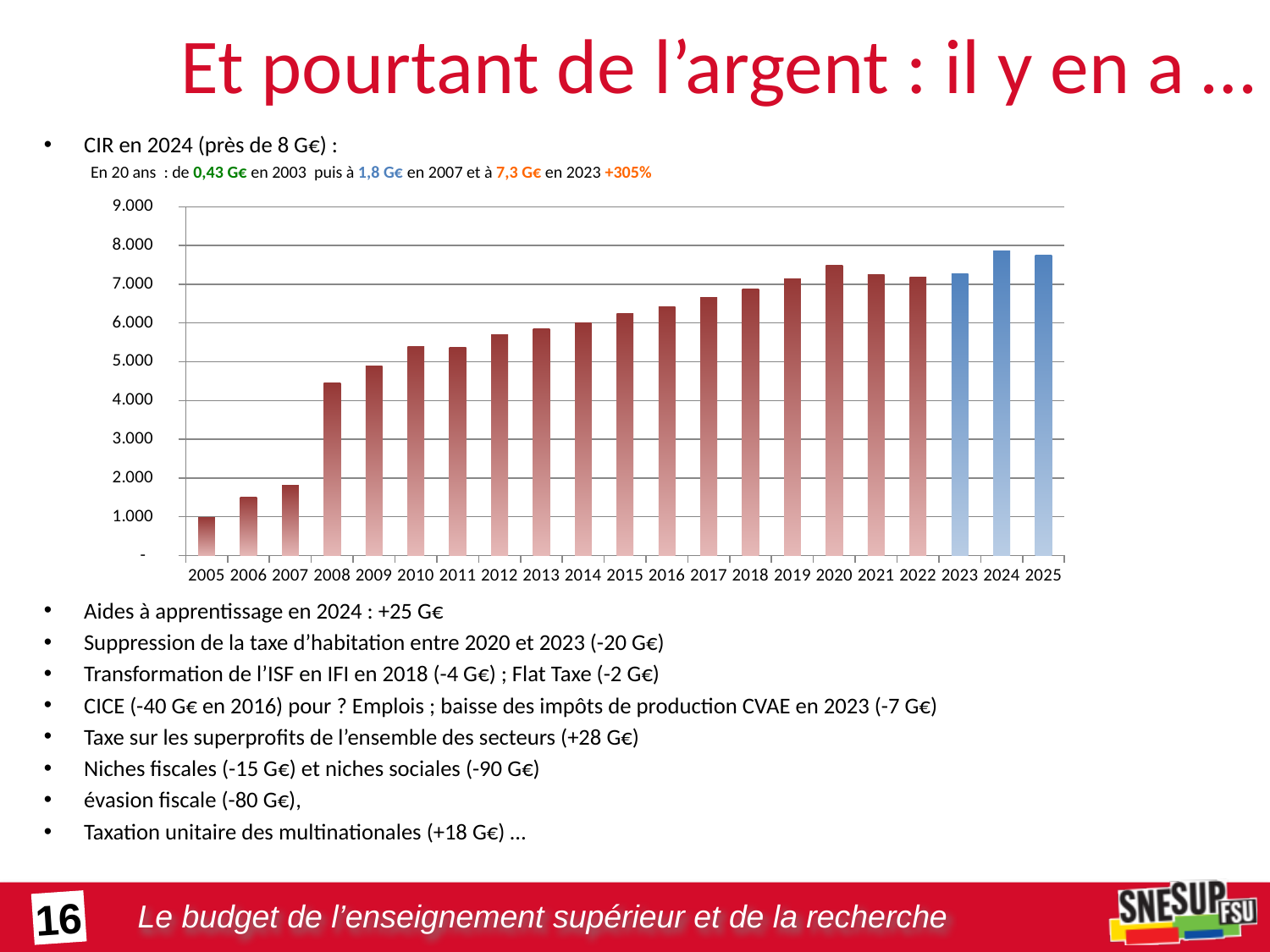
Which is larger, the value for 2019 or the value for 2020? 2020 Is the value for 2008 greater or less than 4.000? greater How many years (bars) are plotted on the chart? 21 Is the value for 2020 greater or less than 7.000? greater Which year has the highest bar on the chart? 2024 What kind of chart is shown on the slide? bar chart Which years are shown with blue bars instead of red bars? 2023, 2024 and 2025 Is the value for 2007 greater or less than 2.000? less Which is larger, the value for 2007 or the value for 2008? 2008 Which year has the lowest bar on the chart? 2005 Overall, do the values rise or fall from 2005 to 2025? rise